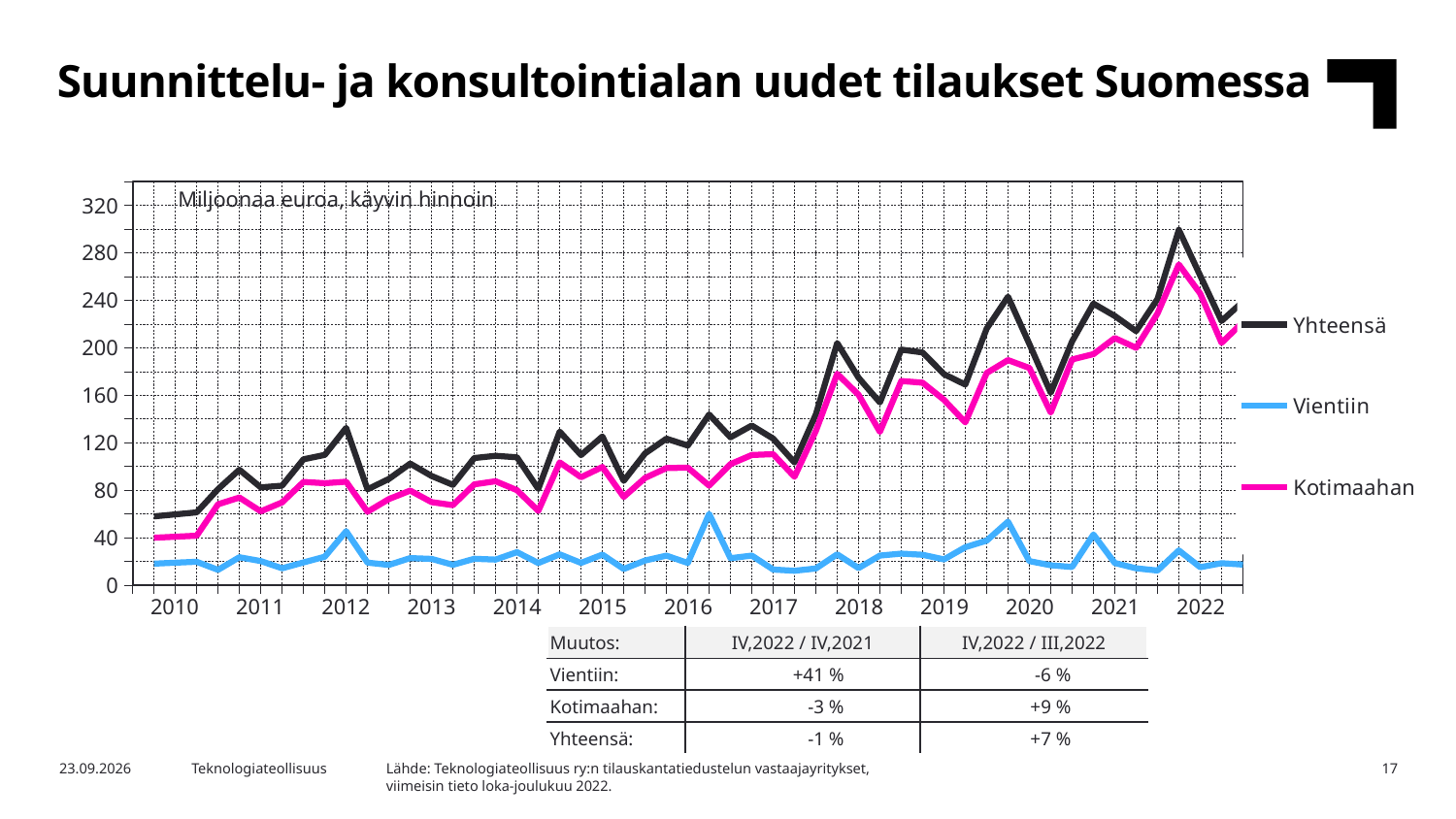
Which series has the lowest values throughout the chart? Vientiin Which series is larger in 2020, Kotimaahan or Vientiin? Kotimaahan How many series does the chart legend list? 3 Is the peak value of the Kotimaahan line in late 2021 greater or less than 240? greater Which series has the highest values throughout the chart? Yhteensä Is the value of the Vientiin line at the start of 2010 greater or less than 40? less What unit is stated in the label inside the chart area? Miljoonaa euroa, käyvin hinnoin Does the Yhteensä line generally rise or fall from 2010 to 2022? rise Is the value of the Yhteensä line at the start of 2010 greater or less than 80? less What are the three series named in the chart legend? Yhteensä, Vientiin, Kotimaahan What kind of chart is shown on the slide? line chart